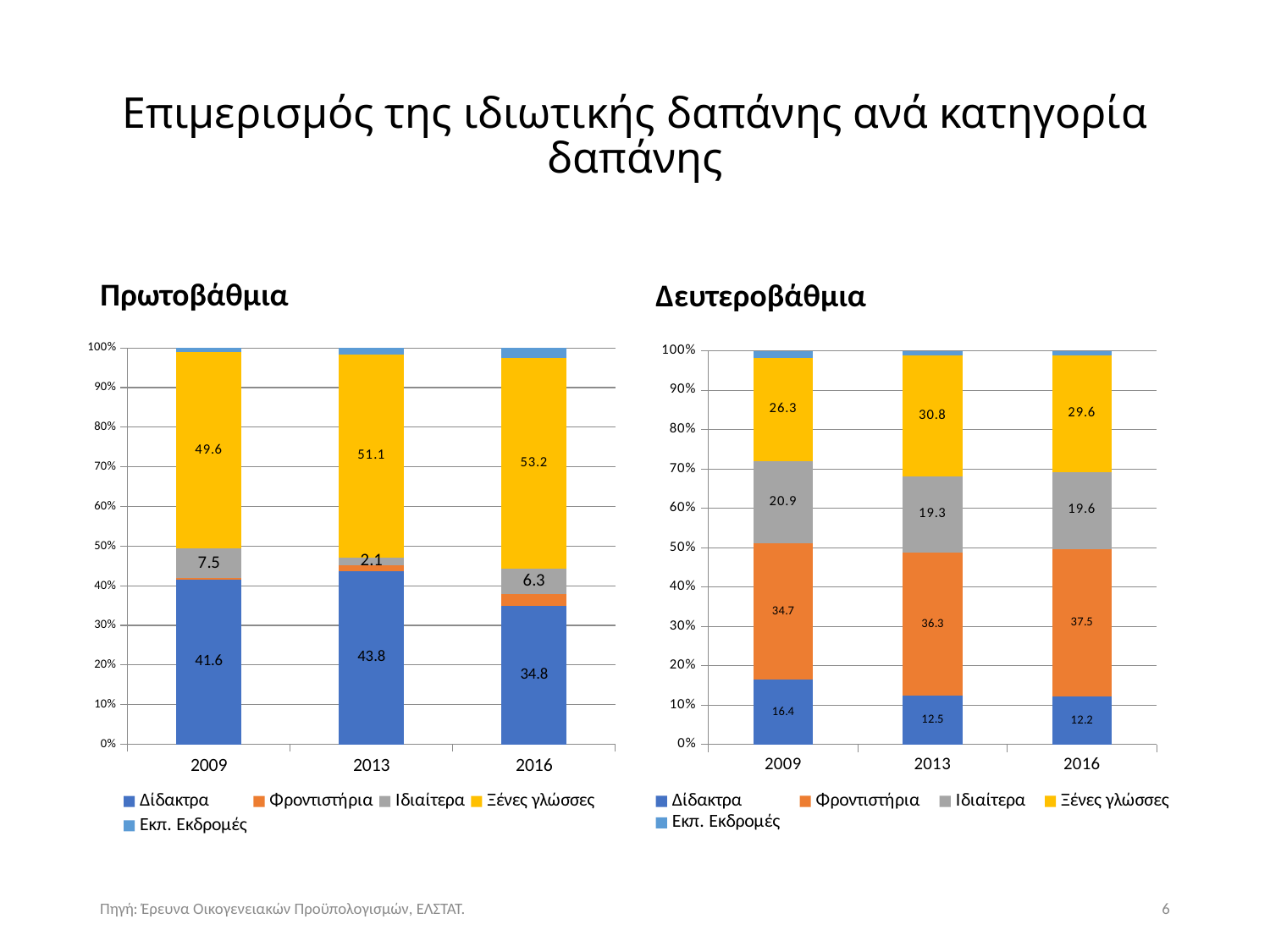
In the Πρωτοβάθμια chart, what is the value of Ξένες γλώσσες for 2013? 51.1 In the Πρωτοβάθμια chart, which year has the highest value for Ξένες γλώσσες? 2016 In the Πρωτοβάθμια chart, which year has the lowest value for Ιδιαίτερα? 2013 In the Δευτεροβάθμια chart, what is the value of Ιδιαίτερα for 2009? 20.9 In the Δευτεροβάθμια chart, which year has the lowest value for Δίδακτρα? 2016 In the Πρωτοβάθμια chart, what is the value of Δίδακτρα for 2016? 34.8 How many series does the legend of the Δευτεροβάθμια chart list? 5 In the Δευτεροβάθμια chart, does the value of Φροντιστήρια rise or fall from 2009 to 2016? rise In the Δευτεροβάθμια chart, what is the difference between the Ξένες γλώσσες values for 2013 and 2009? 4.5 In the Δευτεροβάθμια chart, what is the value of Φροντιστήρια for 2016? 37.5 What kind of chart is the Πρωτοβάθμια chart? stacked bar chart In the Πρωτοβάθμια chart, which is larger: Δίδακτρα in 2013 or Δίδακτρα in 2016? Δίδακτρα in 2013